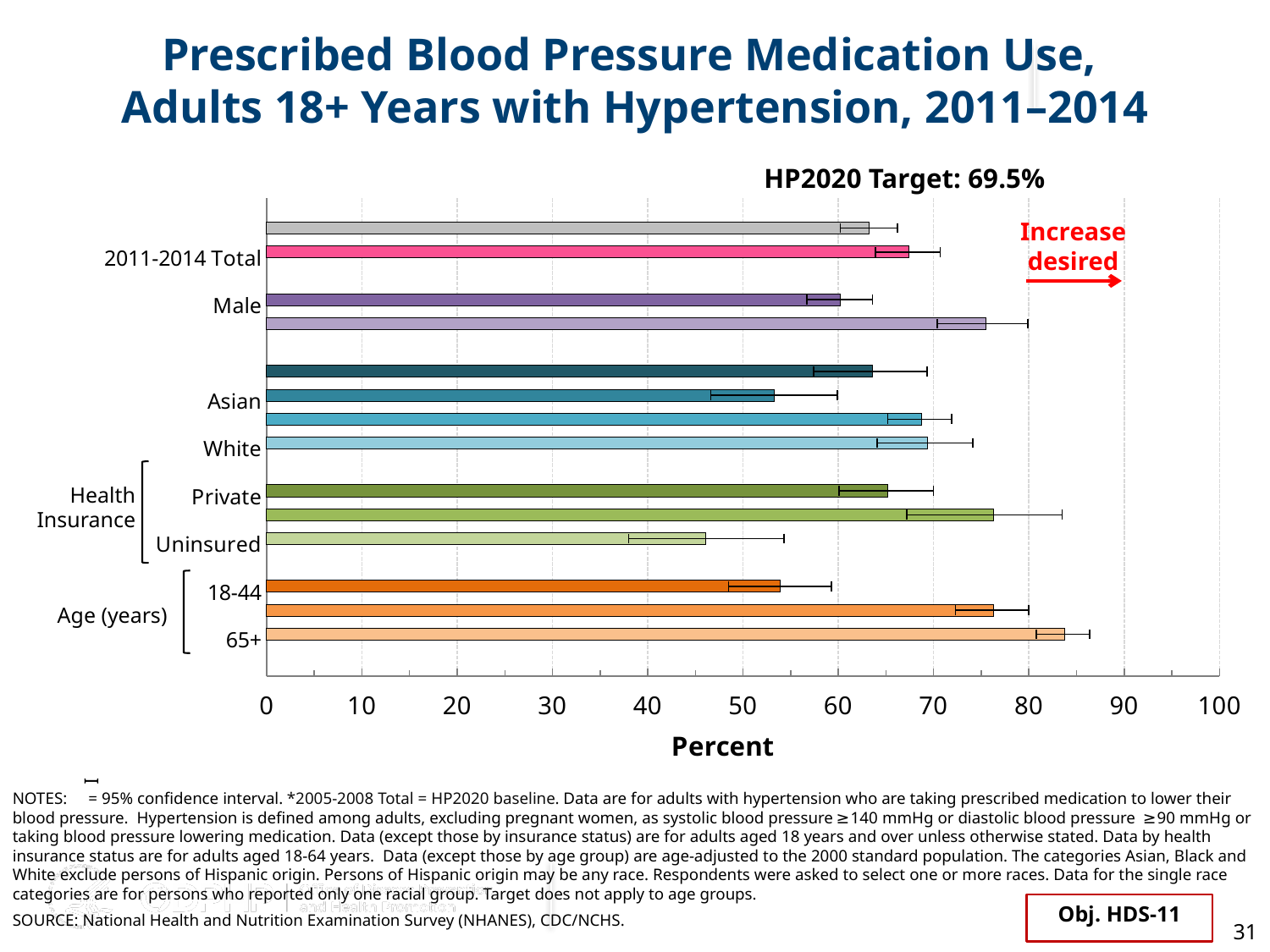
Which bar has the highest value on the chart? 65+ Is the value for Private greater or less than 60? greater Is the value for 65+ greater or less than 80? greater What is the title of the horizontal axis? Percent Which has the larger value, Uninsured or Private? Private Which bar has the lowest value on the chart? Uninsured Is the value for Uninsured greater or less than 50? less Which has the larger value, Asian or White? White What kind of chart is shown on the slide? bar chart What is the HP2020 Target value shown on the slide? 69.5%